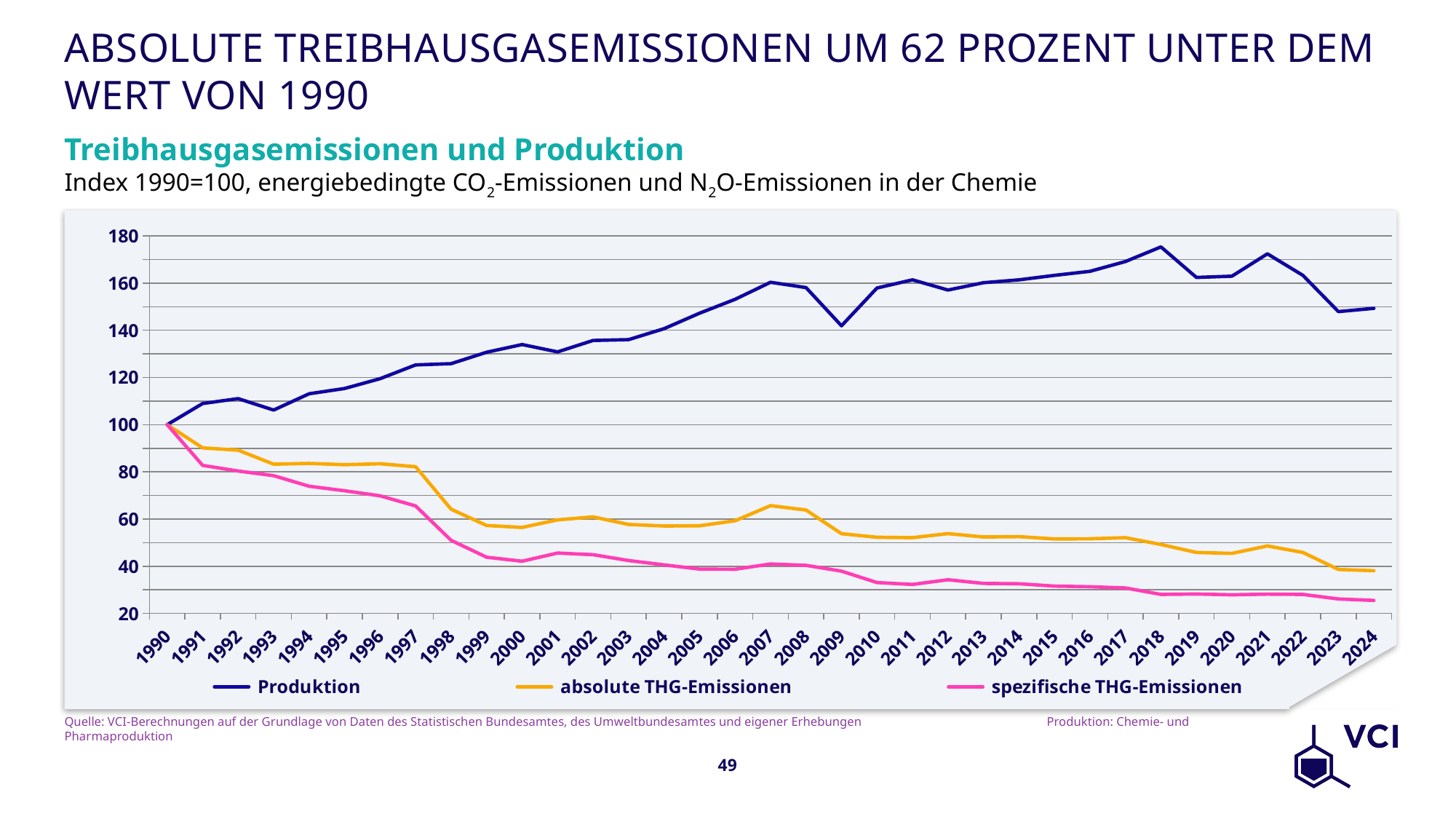
How many years are plotted along the x axis? 35 Is the value for absolute THG-Emissionen in 2024 greater or less than 40? less What is the title of the chart? Treibhausgasemissionen und Produktion In 2024, which is larger: Produktion or absolute THG-Emissionen? Produktion Is the value for Produktion in 2018 greater or less than 160? greater Is the value for spezifische THG-Emissionen in 2024 greater or less than 40? less Does the absolute THG-Emissionen line generally rise or fall from 1990 to 2024? fall What kind of chart is shown on the slide? line chart How many series does the legend list? 3 In which year does Produktion reach its highest value? 2018 What is the value of Produktion in 1990? 100